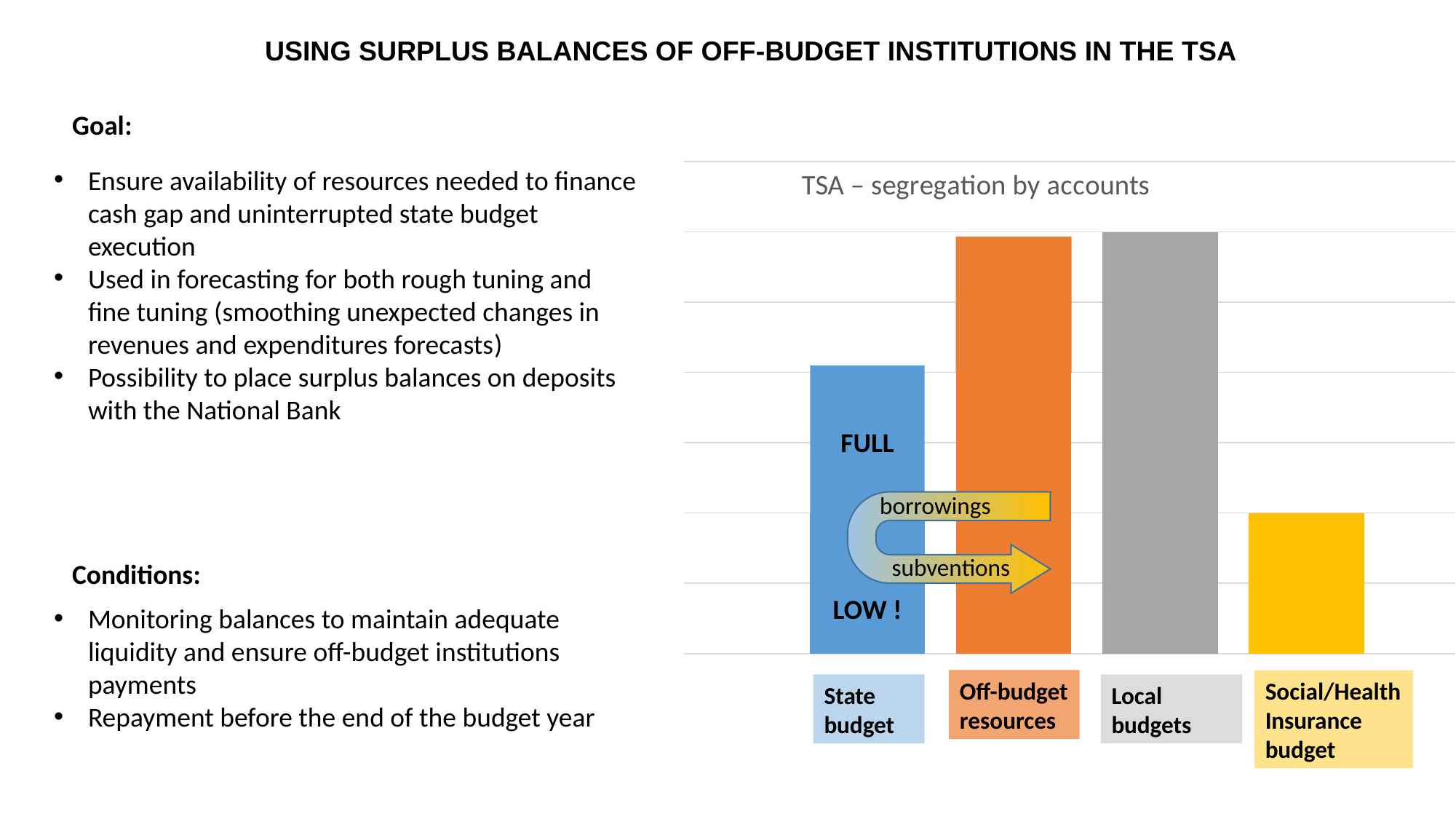
What are the two labels on the arrows drawn between the State budget and Off-budget resources bars? borrowings and subventions How many categories (bars) does the chart show? 4 Which category has the lowest bar in the chart? Social/Health Insurance budget Which bar is taller: State budget or Social/Health Insurance budget? State budget What is the title of the chart? TSA – segregation by accounts Which bar is taller: Local budgets or Social/Health Insurance budget? Local budgets Which bar is taller: State budget or Off-budget resources? Off-budget resources What kind of chart is shown on the slide? bar chart What colour is the bar for Off-budget resources? orange